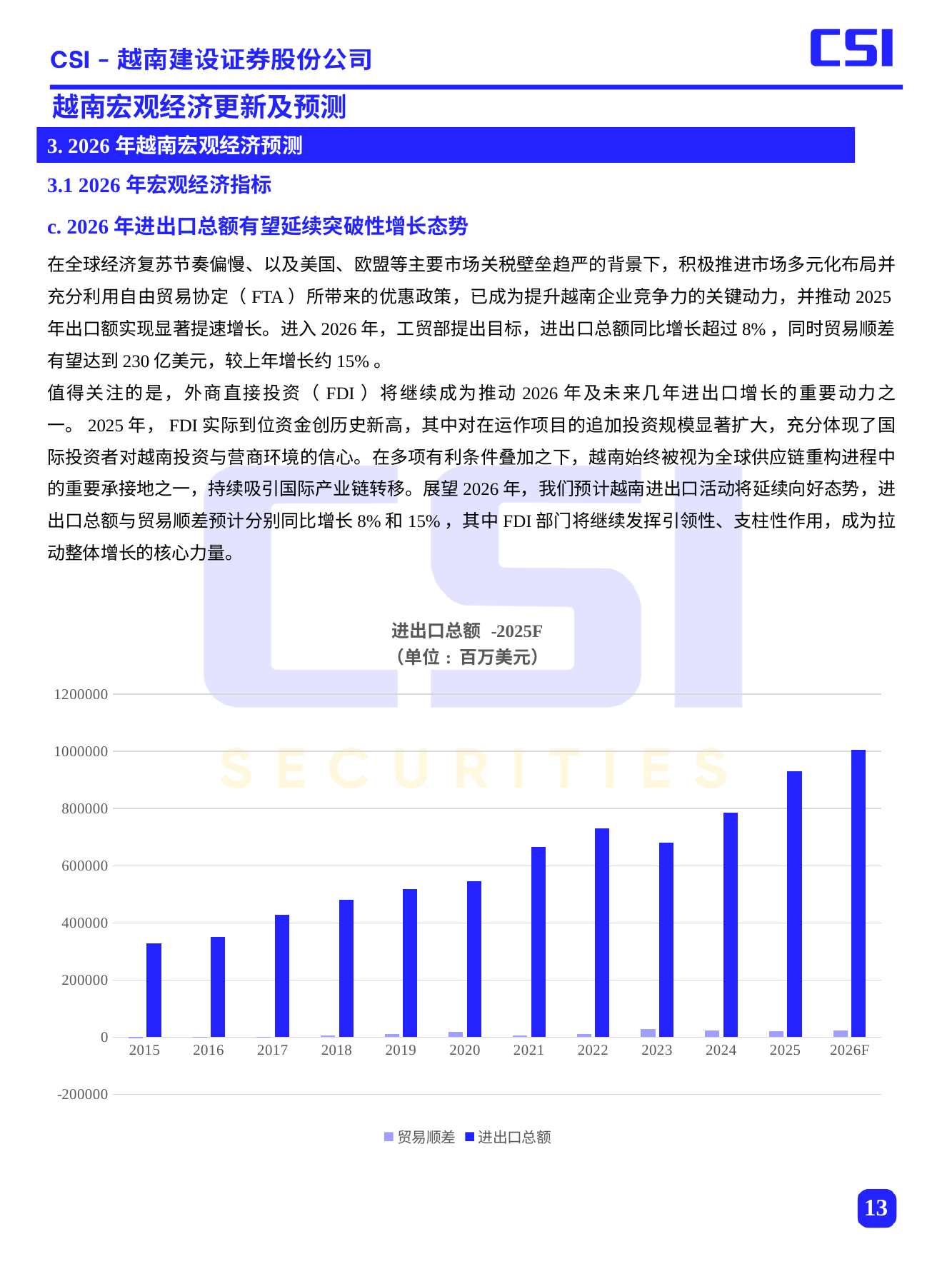
Which year has the highest 进出口总额 value in the chart? 2026F What unit is stated in the chart title? 百万美元 What kind of chart is shown on the slide? bar chart Is the 进出口总额 value for 2015 greater or less than 400000? less How many series does the chart legend list? 2 Is the 进出口总额 value for 2023 greater or less than 800000? less Which year has the larger 进出口总额 value, 2022 or 2023? 2022 Is the 进出口总额 value for 2020 greater or less than 600000? less How many year categories are shown on the x axis of the chart? 12 Do the 进出口总额 values generally rise or fall from 2015 to 2026F? rise Which year has the lowest 进出口总额 value in the chart? 2015